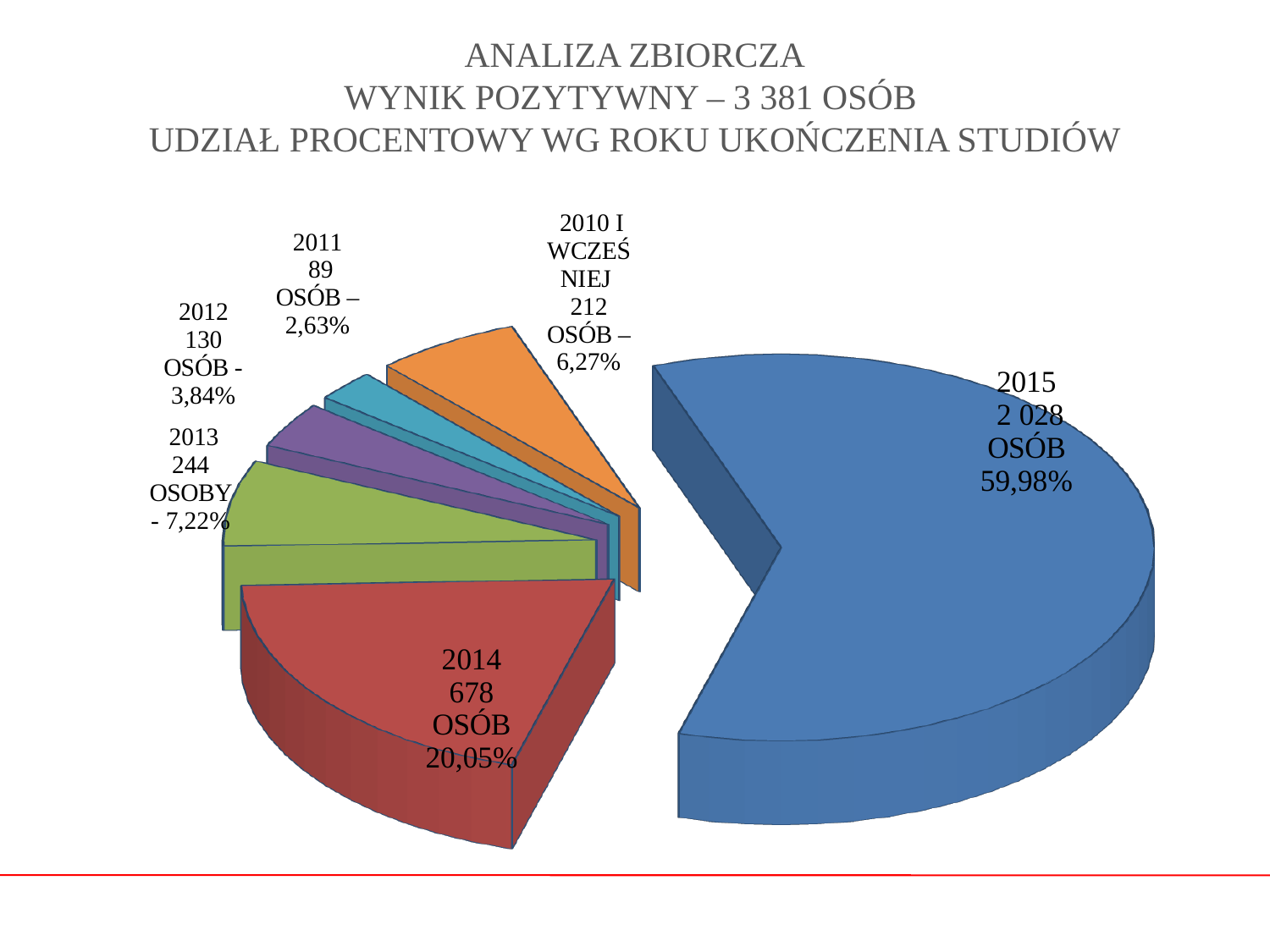
How many people (osób) are in the 2014 slice? 678 What kind of chart is shown on the slide? pie chart What is the difference in number of people between the 2015 and 2014 slices? 1 350 Which slice is larger: 2013 or '2010 i wcześniej'? 2013 What percentage share does the '2010 i wcześniej' slice have? 6,27% What total number of people is stated in the chart title? 3 381 How many people are in the 2012 slice? 130 What percentage share does the 2015 slice have? 59,98% What percentage share does the 2013 slice have? 7,22% Which year has the largest slice of the pie? 2015 Which year has the smallest slice of the pie? 2011 How many slices does the pie chart have? 6